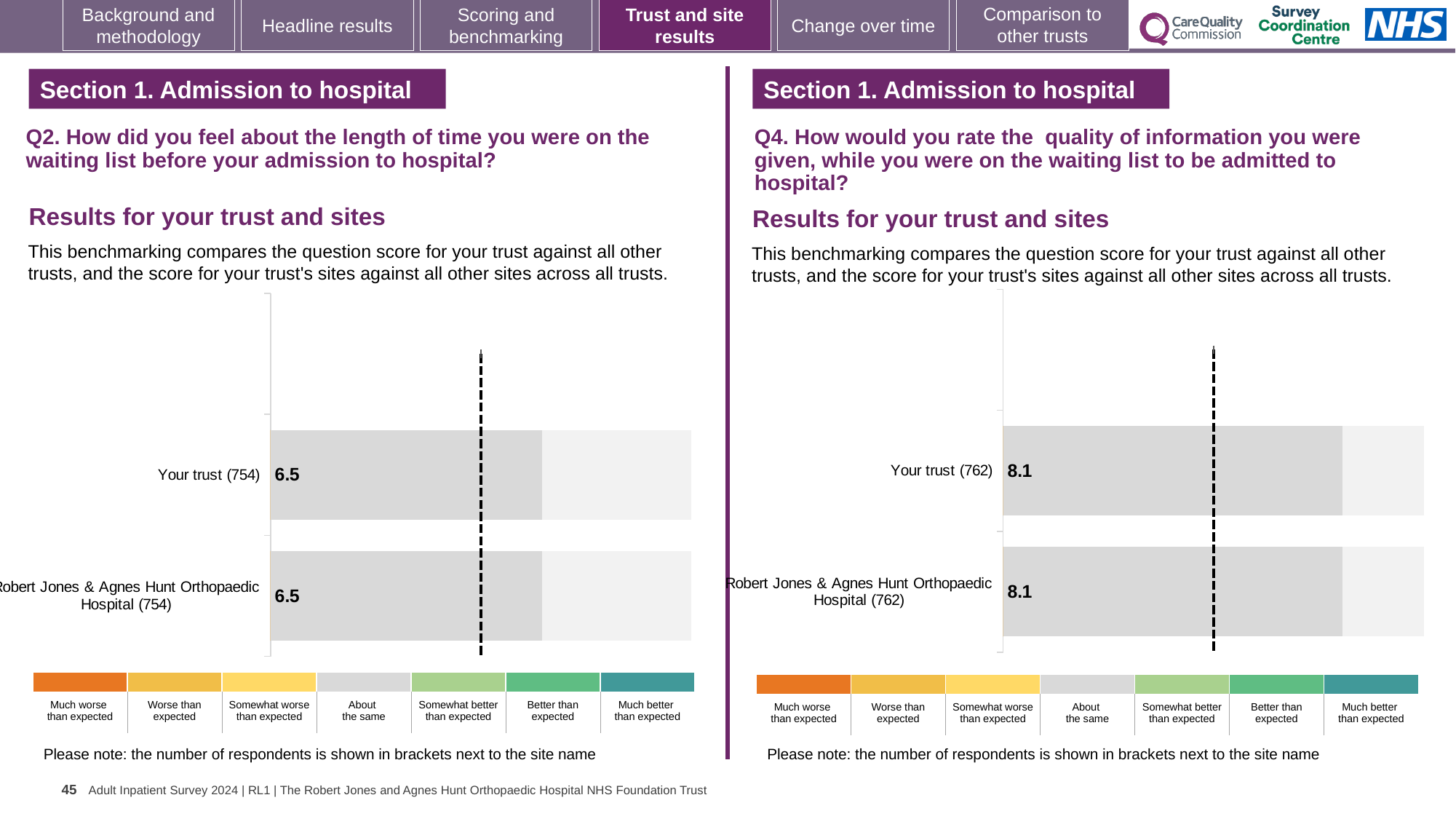
In the right chart (Q4), how many respondents are shown in brackets next to Robert Jones & Agnes Hunt Orthopaedic Hospital? 762 In the left chart (Q2), what is the difference between the score for Your trust and the score for Robert Jones & Agnes Hunt Orthopaedic Hospital? 0.0 In the right chart (Q4), what is the score for Robert Jones & Agnes Hunt Orthopaedic Hospital? 8.1 What kind of chart is used on the left side of the slide for Q2? Bar chart In the left chart (Q2), how many respondents are shown in brackets next to Your trust? 754 How many bars are plotted in the right chart (Q4)? 2 Is the score for Your trust in the right chart (Q4) greater or less than the score for Your trust in the left chart (Q2)? greater In the right chart (Q4), what is the score for Your trust? 8.1 In the right chart (Q4), what is the difference between the score for Your trust and the score for Robert Jones & Agnes Hunt Orthopaedic Hospital? 0.0 In the left chart (Q2), what is the score for Robert Jones & Agnes Hunt Orthopaedic Hospital? 6.5 In the left chart (Q2), what is the score for Your trust? 6.5 How many bars are plotted in the left chart (Q2)? 2